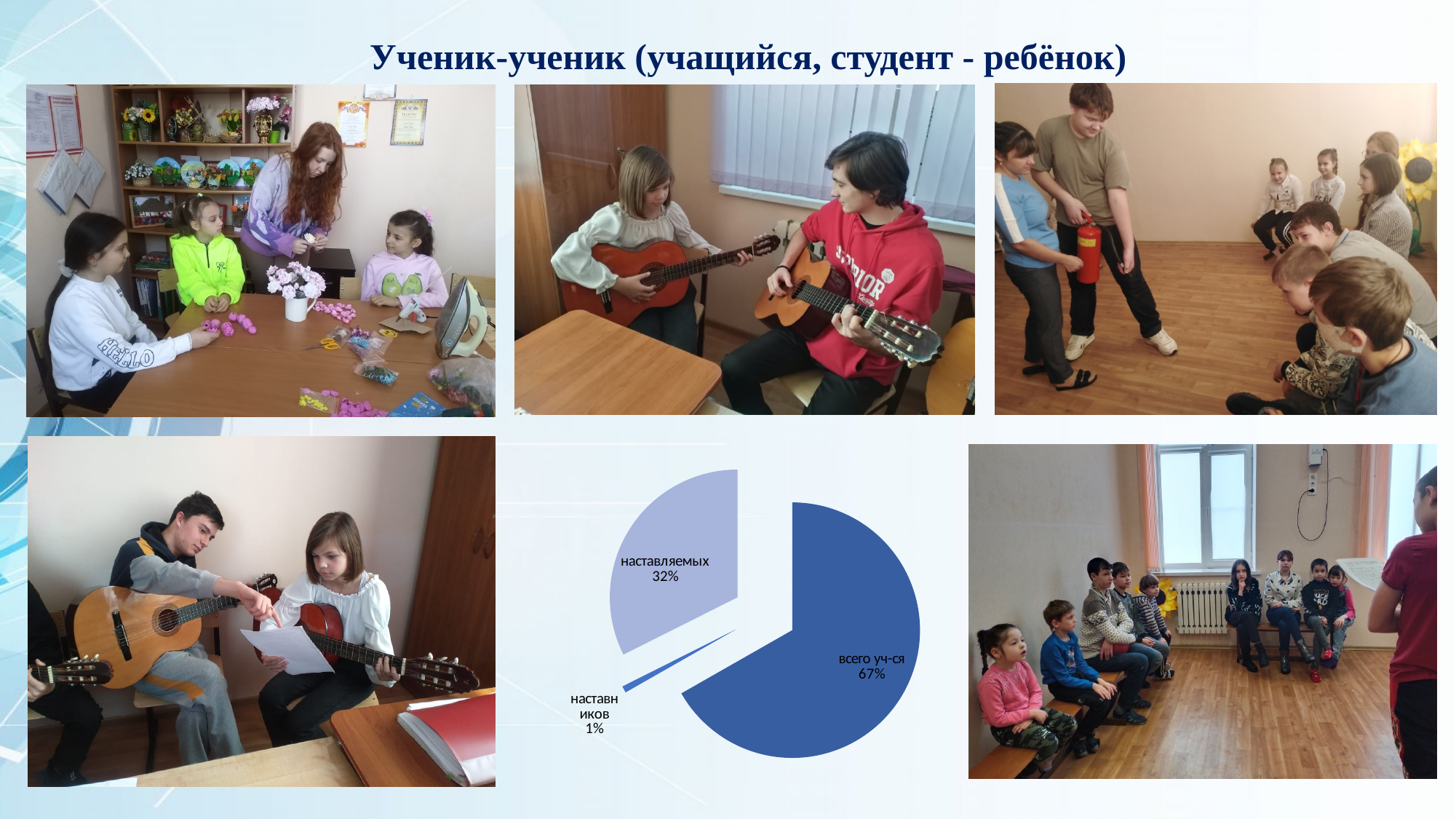
What is the difference in percentage points between the "наставляемых" slice and the "наставников" slice? 31 Which is larger: the "наставляемых" slice or the "наставников" slice? наставляемых Which slice of the pie chart is the smallest? наставников What is the difference in percentage points between the "всего уч-ся" slice and the "наставляемых" slice? 35 How many slices does the pie chart have? 3 Which slice of the pie chart is the largest? всего уч-ся What share of the pie does the slice "наставников" represent? 1% What kind of chart is shown on the slide? pie chart What share of the pie does the slice "всего уч-ся" represent? 67% Which slice of the pie chart is drawn in the darkest blue? всего уч-ся What share of the pie does the slice "наставляемых" represent? 32%